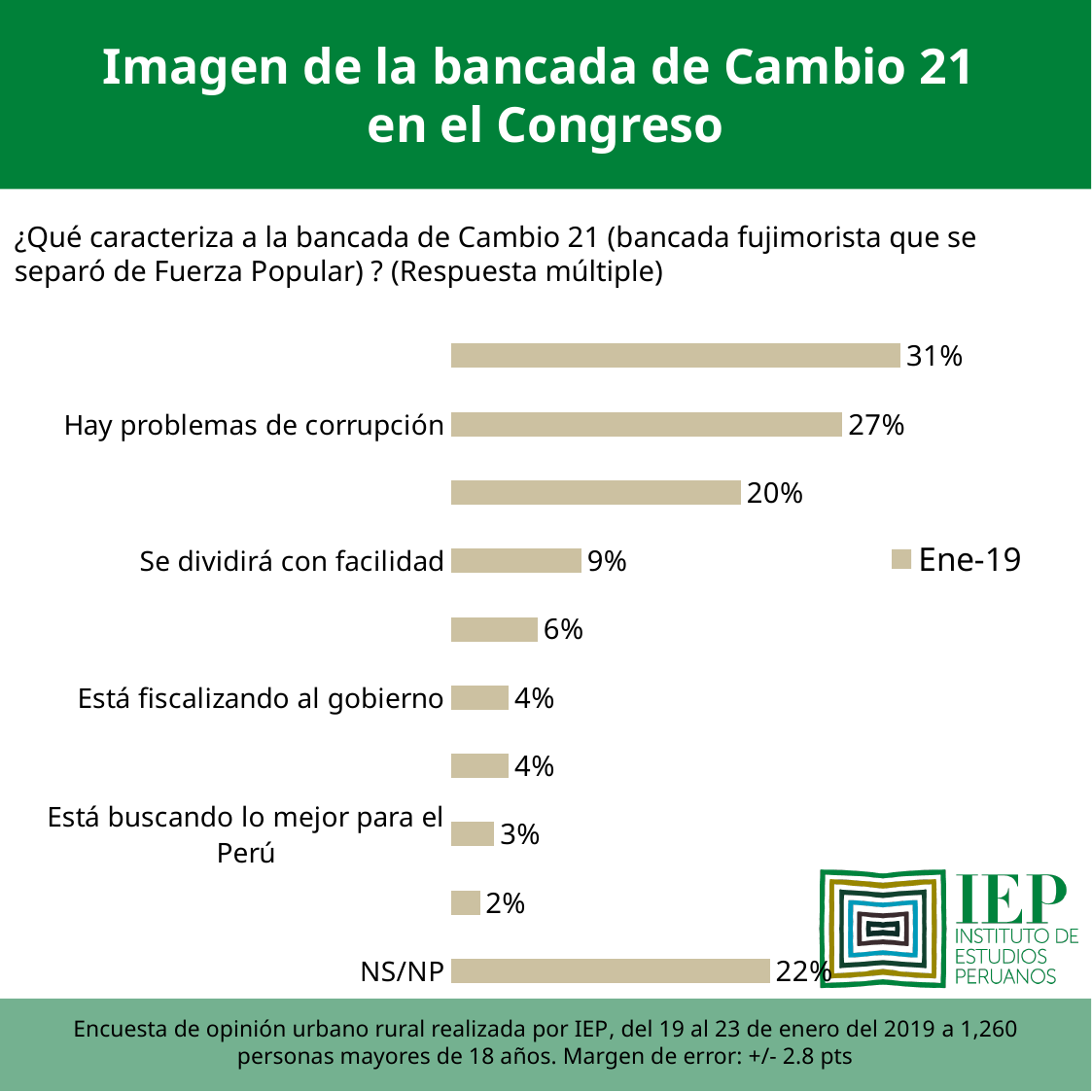
What is the difference between the values for "Hay problemas de corrupción" and "NS/NP"? 5% What value is shown for "Está fiscalizando al gobierno"? 4% What value is shown for "Está buscando lo mejor para el Perú"? 3% Which is larger, the value for "NS/NP" or the value for "Hay problemas de corrupción"? Hay problemas de corrupción What value is shown for "Se dividirá con facilidad"? 9% How many series does the legend list? 1 How many bars are plotted in the chart? 10 What value is shown for "Hay problemas de corrupción"? 27% What kind of chart is shown on the slide? Bar chart What value is shown for "NS/NP"? 22% Which is larger, the value for "Se dividirá con facilidad" or the value for "Está buscando lo mejor para el Perú"? Se dividirá con facilidad What is the difference between the values for "Se dividirá con facilidad" and "Está fiscalizando al gobierno"? 5%